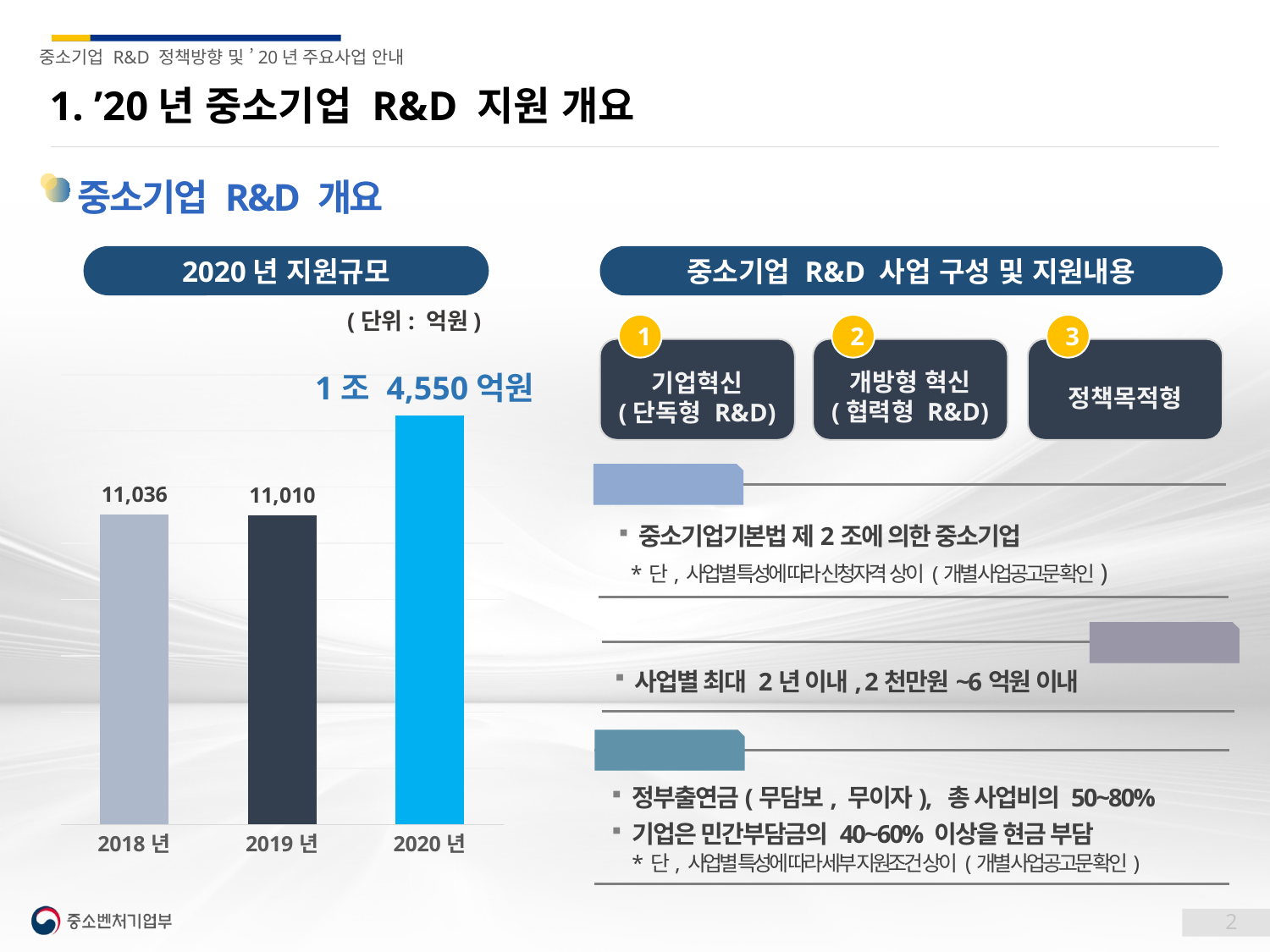
What kind of chart is the 2020 년 지원규모 chart? Bar chart What is the value for 2018 년 in the 2020 년 지원규모 chart? 11,036 Which is larger in the 2020 년 지원규모 chart, the value for 2018 년 or 2019 년? 2018 년 What is the difference between the 2018 년 and 2019 년 values in the 2020 년 지원규모 chart? 26 Which year has the lowest value in the 2020 년 지원규모 chart? 2019 년 How many bars are shown in the 2020 년 지원규모 chart? 3 What is the value for 2019 년 in the 2020 년 지원규모 chart? 11,010 What unit is stated for the values in the 2020 년 지원규모 chart? 억원 What colour is the 2020 년 bar in the 2020 년 지원규모 chart? Light blue Which year has the highest bar in the 2020 년 지원규모 chart? 2020 년 Does the value rise or fall from 2019 년 to 2020 년 in the 2020 년 지원규모 chart? Rise What value is labelled on the 2020 년 bar in the 2020 년 지원규모 chart? 1 조 4,550 억원